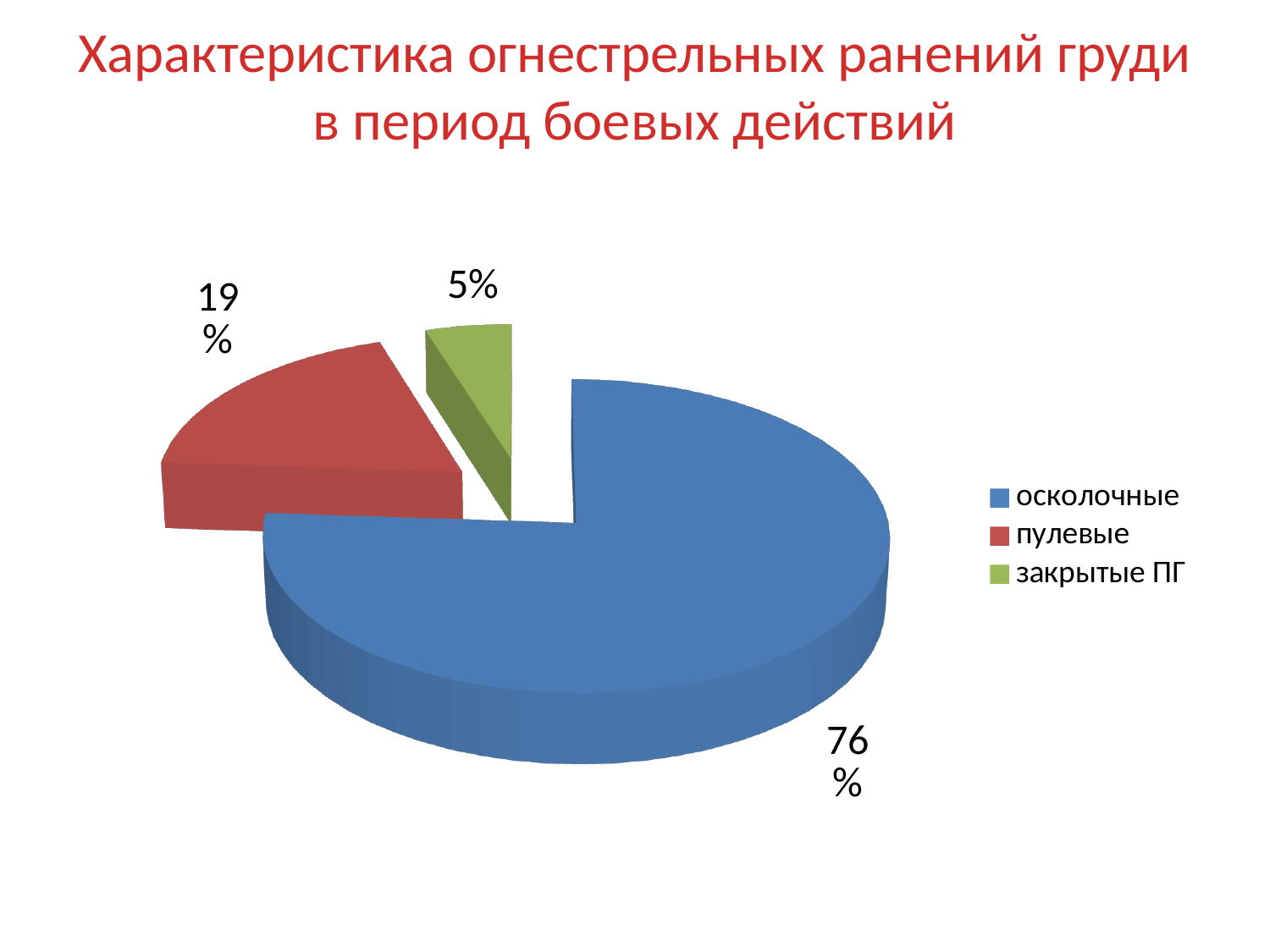
What share of the pie does the закрытые ПГ slice represent? 5% How many categories does the pie chart show? 3 What is the difference in percentage points between the пулевые and закрытые ПГ slices? 14 What share of the pie does the пулевые slice represent? 19% What kind of chart is shown on the slide? pie chart Which category has the smallest slice of the pie? закрытые ПГ What is the title of the slide? Характеристика огнестрельных ранений груди в период боевых действий What share of the pie does the осколочные slice represent? 76% What is the difference in percentage points between the осколочные and пулевые slices? 57 Which is larger, the пулевые slice or the закрытые ПГ slice? пулевые Which category has the largest slice of the pie? осколочные What colour is the пулевые slice? red